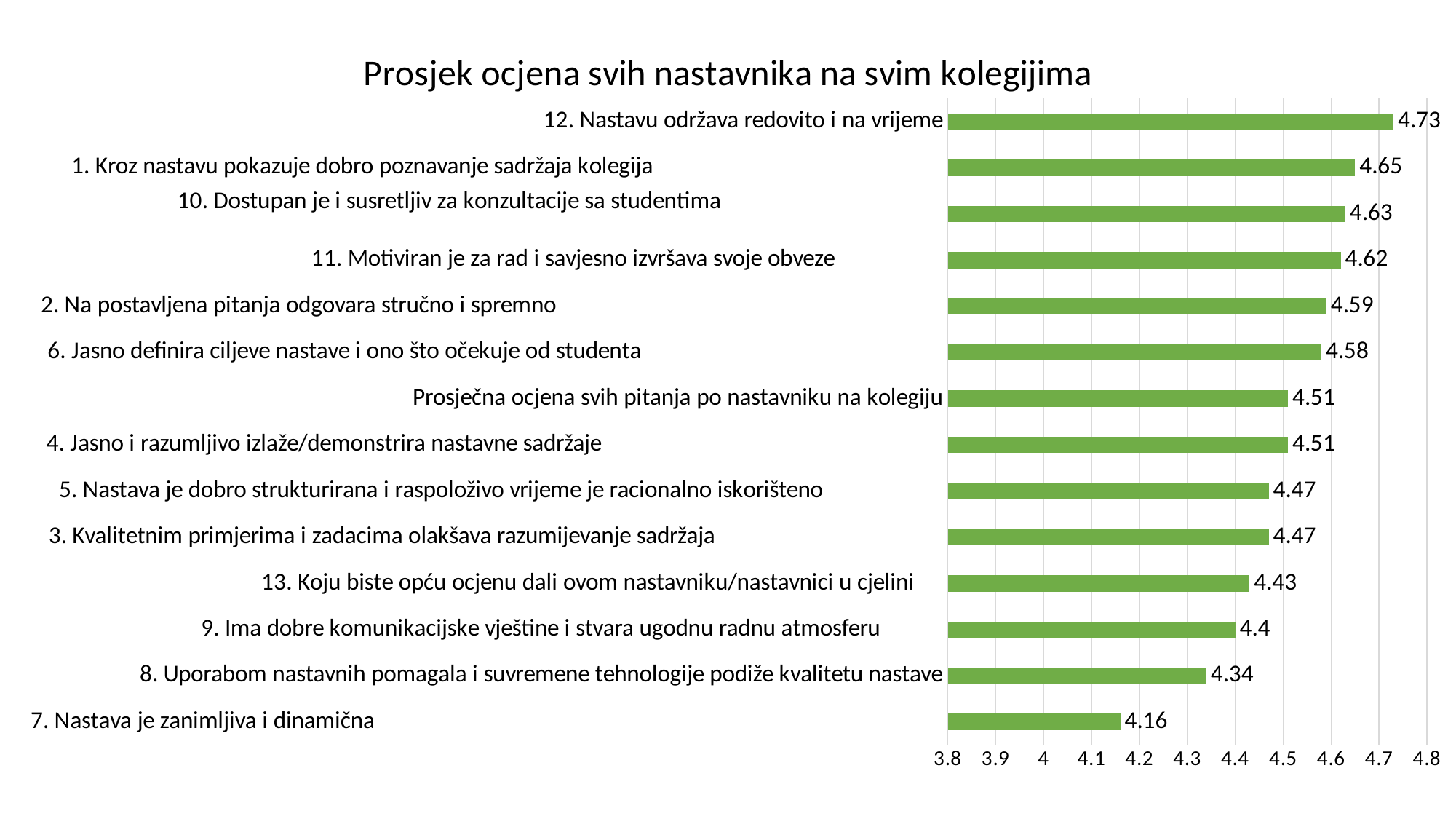
What is the value for "12. Nastavu održava redovito i na vrijeme"? 4.73 Is the value for "1. Kroz nastavu pokazuje dobro poznavanje sadržaja kolegija" greater or less than 4.6? greater What kind of chart is shown on the slide? bar chart What is the title of the chart? Prosjek ocjena svih nastavnika na svim kolegijima What is the value for "Prosječna ocjena svih pitanja po nastavniku na kolegiju"? 4.51 Which category has the highest value? 12. Nastavu održava redovito i na vrijeme What is the difference between the values for "12. Nastavu održava redovito i na vrijeme" and "7. Nastava je zanimljiva i dinamična"? 0.57 Which is larger: the value for "8. Uporabom nastavnih pomagala i suvremene tehnologije podiže kvalitetu nastave" or "13. Koju biste opću ocjenu dali ovom nastavniku/nastavnici u cjelini"? 13. Koju biste opću ocjenu dali ovom nastavniku/nastavnici u cjelini What is the value for "9. Ima dobre komunikacijske vještine i stvara ugodnu radnu atmosferu"? 4.4 What is the value for "7. Nastava je zanimljiva i dinamična"? 4.16 How many categories (bars) are shown in the chart? 14 Which category has the lowest value? 7. Nastava je zanimljiva i dinamična